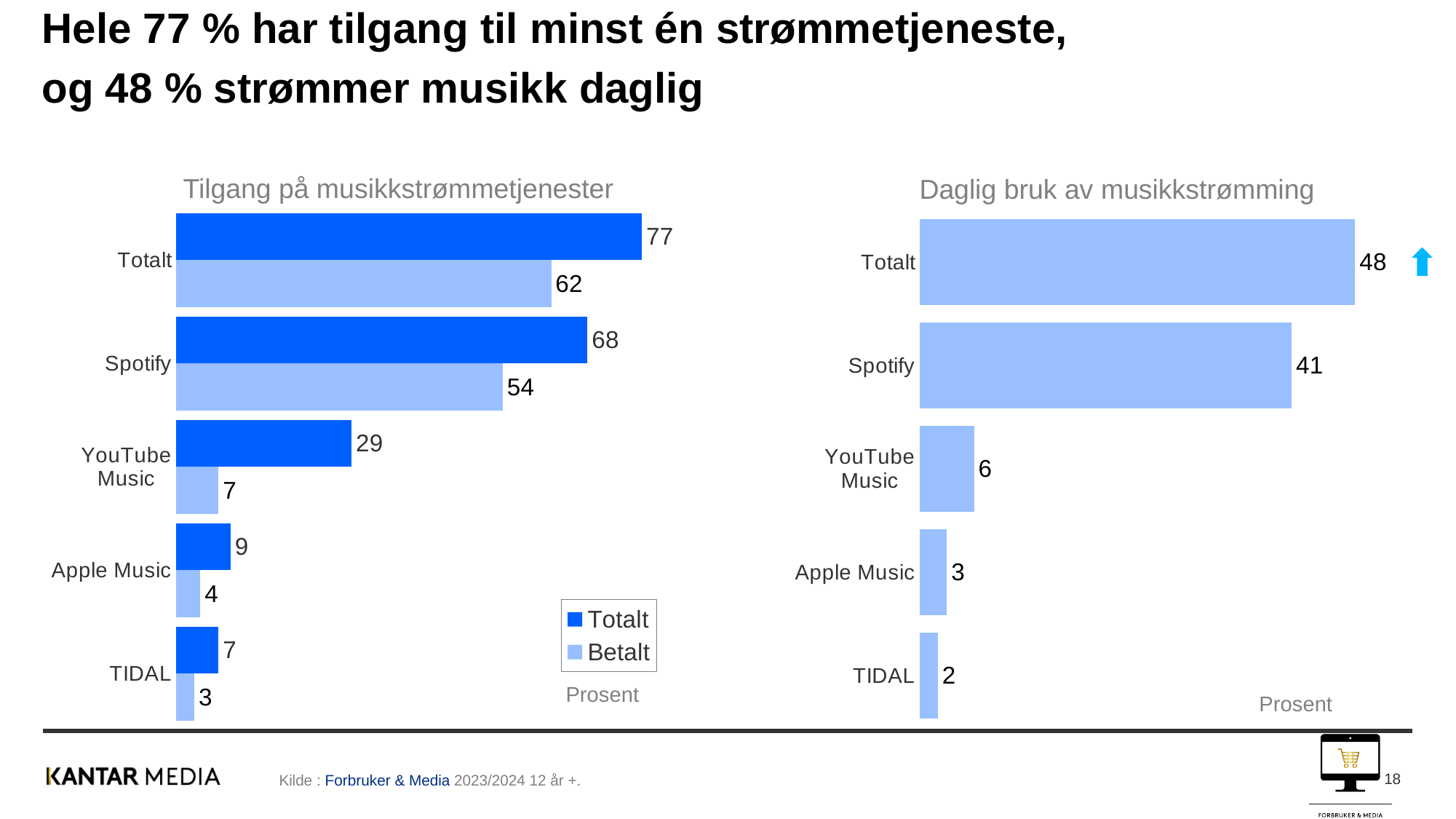
In the 'Tilgang på musikkstrømmetjenester' chart, what is the Betalt value for YouTube Music? 7 In the 'Daglig bruk av musikkstrømming' chart, which category has the lowest value? TIDAL In the 'Tilgang på musikkstrømmetjenester' chart, what is the difference between the Totalt and Betalt values for Spotify? 14 In the 'Daglig bruk av musikkstrømming' chart, what is the value for Apple Music? 3 In the 'Tilgang på musikkstrømmetjenester' chart, what is the Totalt value for Spotify? 68 How many categories are shown in the 'Daglig bruk av musikkstrømming' chart? 5 How many series does the legend of the 'Tilgang på musikkstrømmetjenester' chart list? 2 What kind of chart is the 'Daglig bruk av musikkstrømming' chart? Bar chart What are the two series named in the legend of the 'Tilgang på musikkstrømmetjenester' chart? Totalt and Betalt In the 'Tilgang på musikkstrømmetjenester' chart, which is larger: the Totalt value for YouTube Music or the Totalt value for Apple Music? YouTube Music In the 'Tilgang på musikkstrømmetjenester' chart, which category has the highest Totalt value? Totalt In the 'Daglig bruk av musikkstrømming' chart, what is the difference between the Totalt and Spotify values? 7